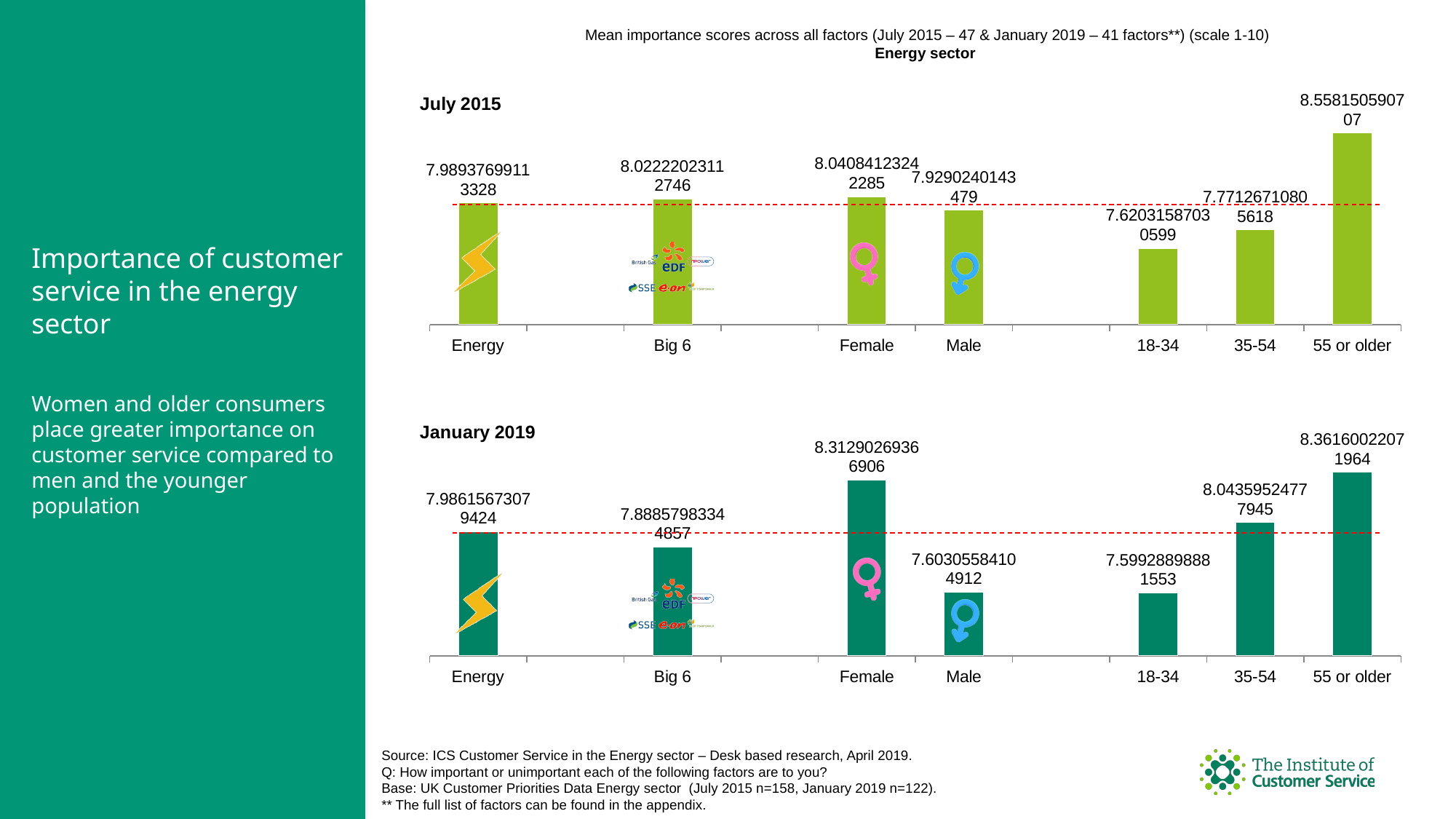
In the July 2015 chart, what is the mean importance score for the 55 or older group? 8.558150590707 In the January 2019 chart, what is the mean importance score for the 18-34 group? 7.59928898881553 Which sector is named in the bold subtitle above the charts? Energy sector In the January 2019 chart, which is higher, the score for Female or the score for Male? Female In the July 2015 chart, what is the mean importance score for Male respondents? 7.9290240143479 In the July 2015 chart, which category has the highest mean importance score? 55 or older In the January 2019 chart, which category has the highest mean importance score? 55 or older In the January 2019 chart, which category has the lowest mean importance score? 18-34 How many categories are shown on the x axis of the July 2015 chart? 7 In the January 2019 chart, what is the mean importance score for Female respondents? 8.31290269366906 In the July 2015 chart, which category has the lowest mean importance score? 18-34 What type of chart is used for the January 2019 data? Bar chart